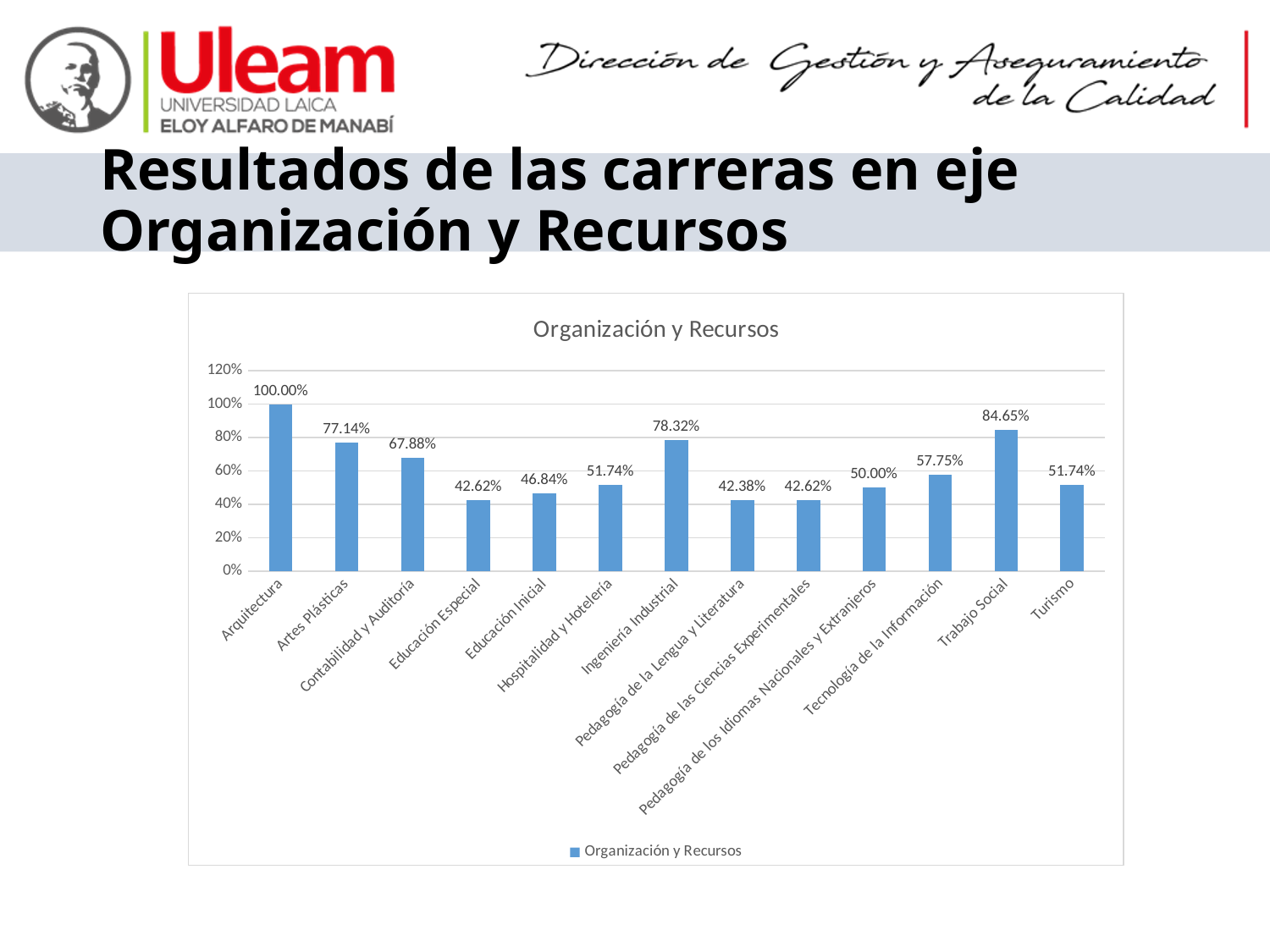
What is the difference between the values for Trabajo Social and Artes Plásticas? 7.51% Which category has the lowest value? Pedagogía de la Lengua y Literatura What is the value for Tecnología de la Información? 57.75% What is the value for Ingeniería Industrial? 78.32% Which is larger, the value for Contabilidad y Auditoría or the value for Hospitalidad y Hotelería? Contabilidad y Auditoría How many series does the legend list? 1 What is the value for Arquitectura? 100.00% What is the title of the chart? Organización y Recursos How many categories are shown on the x axis? 13 Which category has the highest value? Arquitectura Is the value for Educación Inicial greater or less than 60%? less What kind of chart is shown? bar chart